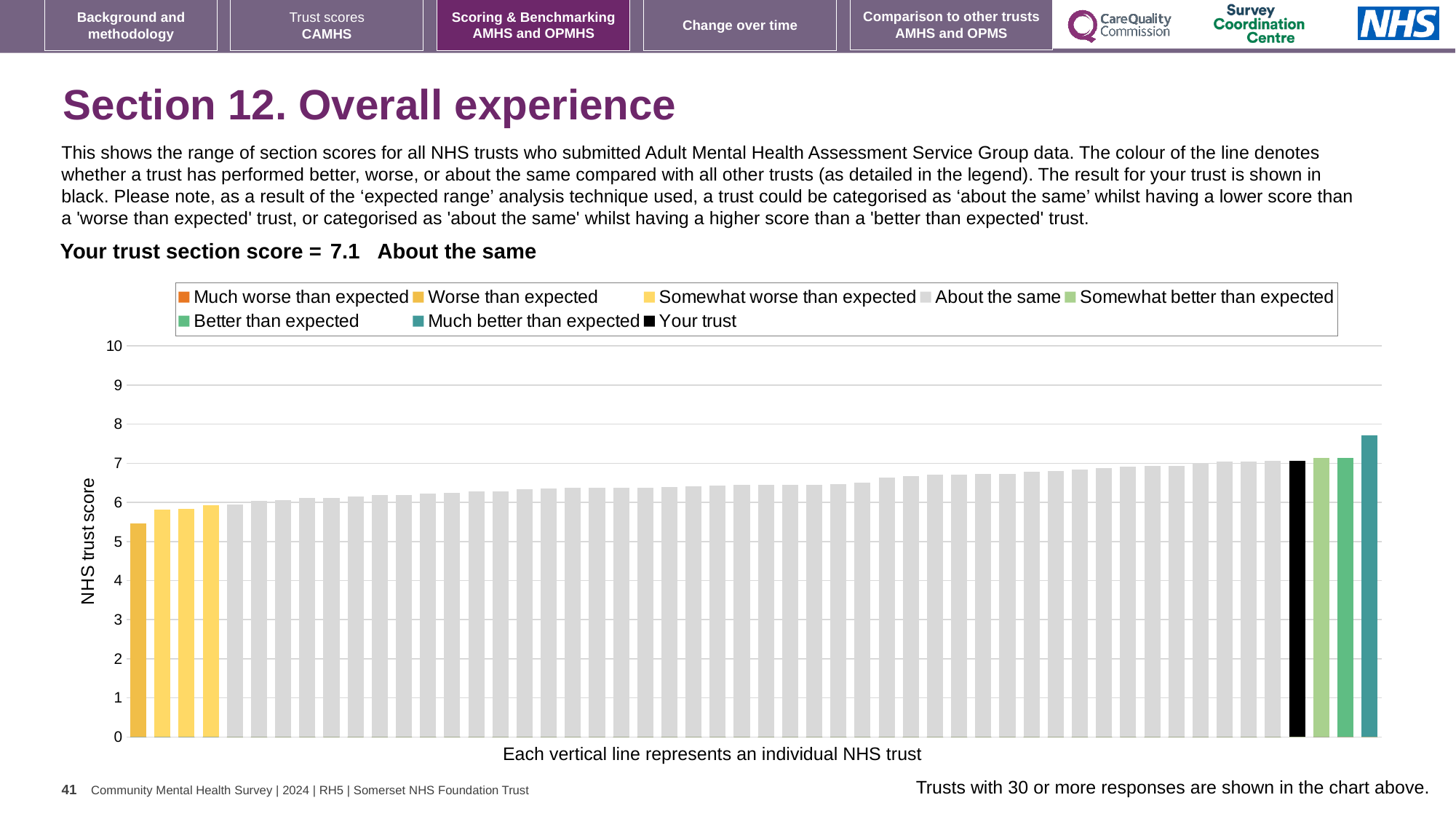
What is the label on the vertical axis of the chart? NHS trust score Is the value of the tallest bar in the chart greater or less than 7? greater Which legend category does the tallest bar in the chart belong to? Much better than expected Which category is your trust placed in according to the slide? About the same How many entries does the chart legend list? 8 Is the value of the black 'Your trust' bar greater or less than 6? greater Is the 'Your trust' bar taller or shorter than the teal 'Much better than expected' bar? shorter Do the bar values rise or fall from left to right across the chart? rise Is the value of the lowest bar in the chart greater or less than 6? less What is the section score for your trust shown on the slide? 7.1 What kind of chart is shown on the slide? bar chart